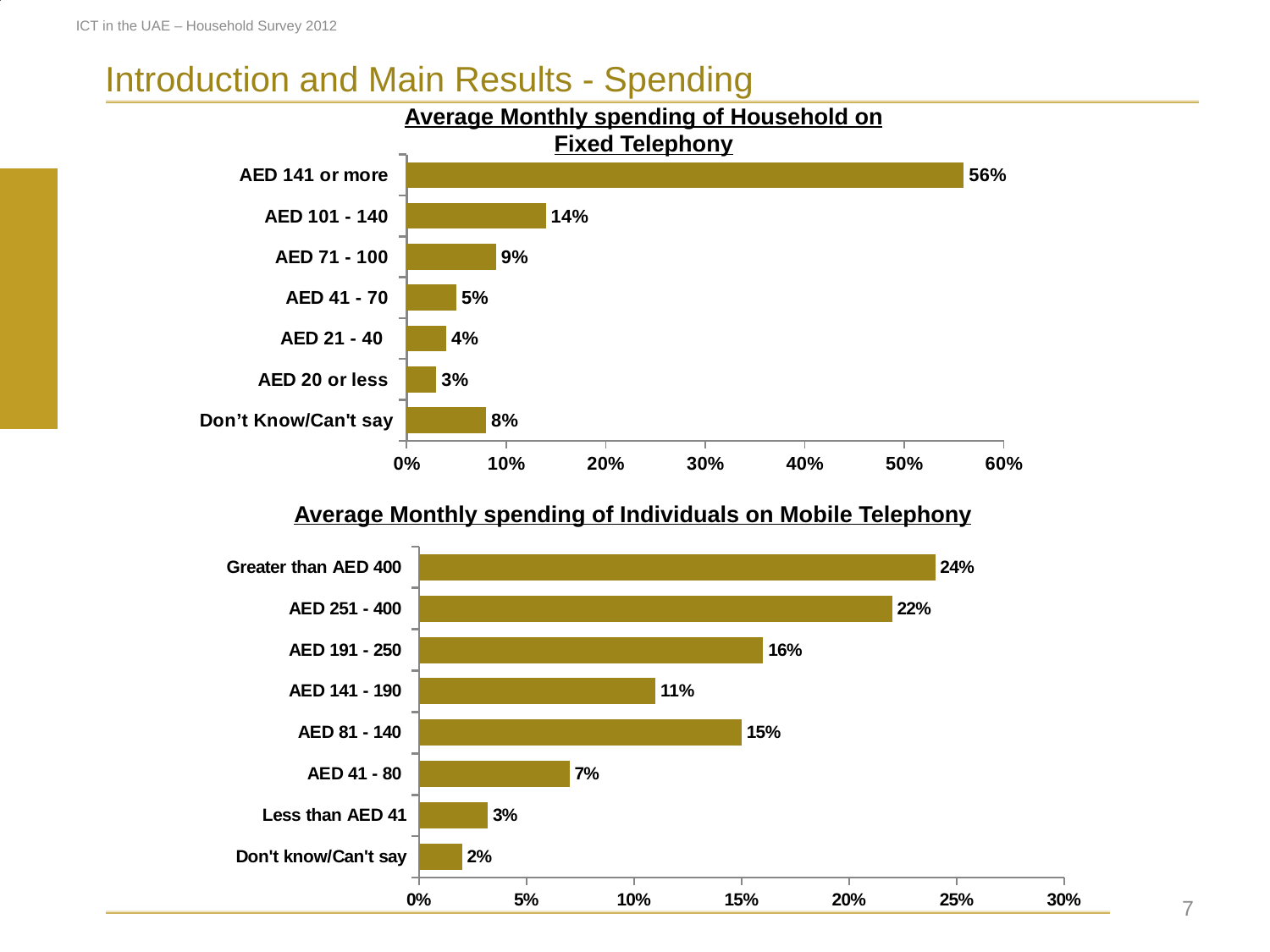
In the 'Average Monthly spending of Household on Fixed Telephony' chart, what is the value for AED 71 - 100? 9% In the 'Average Monthly spending of Household on Fixed Telephony' chart, how many categories are shown? 7 In the 'Average Monthly spending of Individuals on Mobile Telephony' chart, which is larger: AED 141 - 190 or AED 81 - 140? AED 81 - 140 In the 'Average Monthly spending of Household on Fixed Telephony' chart, what percentage of households spend AED 141 or more? 56% In the 'Average Monthly spending of Individuals on Mobile Telephony' chart, what is the value for AED 81 - 140? 15% What type of chart is the 'Average Monthly spending of Individuals on Mobile Telephony' chart? Bar chart In the 'Average Monthly spending of Individuals on Mobile Telephony' chart, which category has the highest value? Greater than AED 400 In the 'Average Monthly spending of Household on Fixed Telephony' chart, which category has the lowest value? AED 20 or less In the 'Average Monthly spending of Household on Fixed Telephony' chart, what is the difference between AED 141 or more and AED 101 - 140? 42 percentage points In the 'Average Monthly spending of Individuals on Mobile Telephony' chart, what is the difference between AED 251 - 400 and AED 191 - 250? 6 percentage points In the 'Average Monthly spending of Household on Fixed Telephony' chart, what is the value for Don't Know/Can't say? 8% In the 'Average Monthly spending of Individuals on Mobile Telephony' chart, how many categories are shown? 8